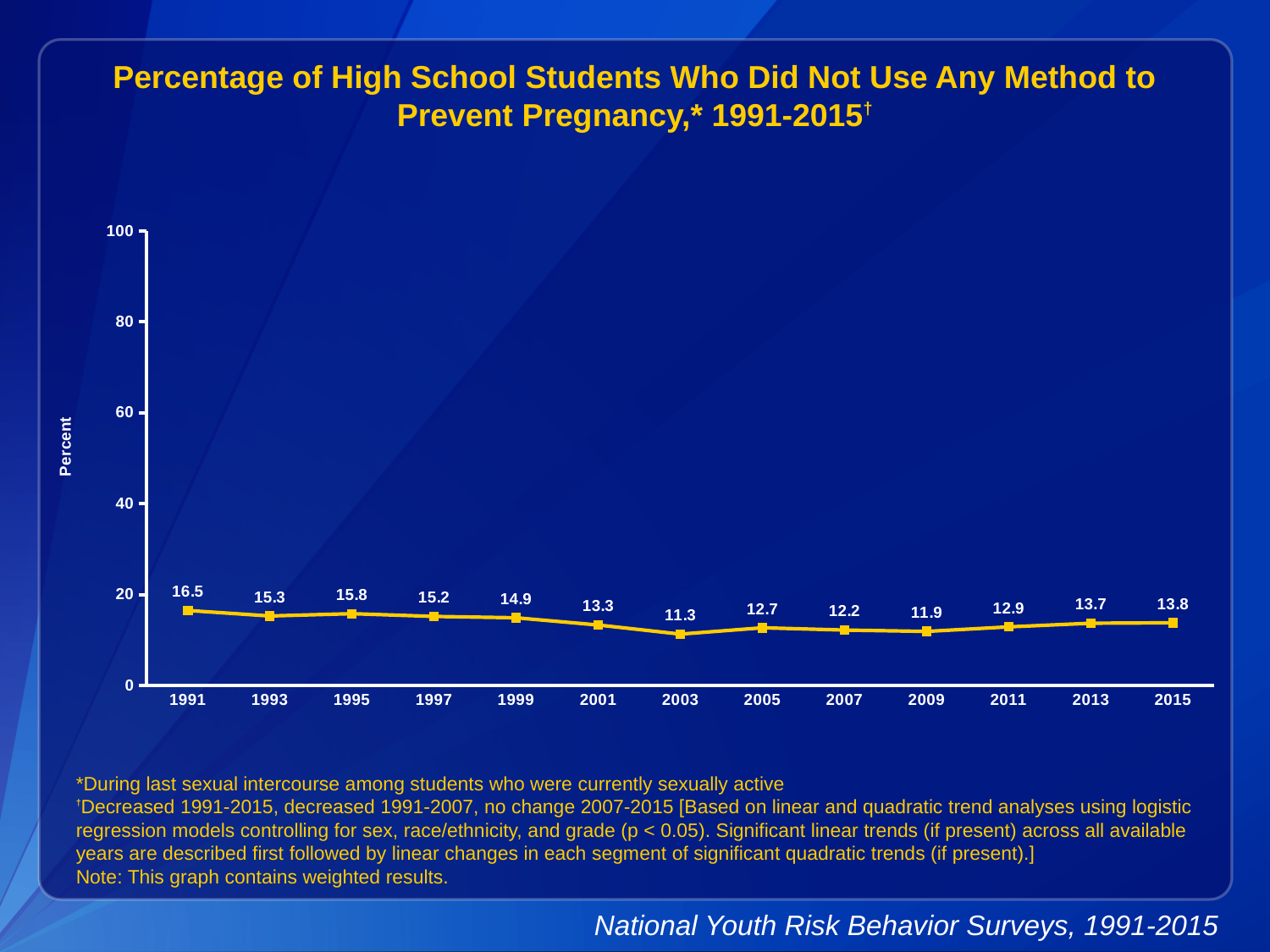
Do the values generally rise or fall from 1991 to 2003? fall What is the label on the y axis? Percent Which year has the highest value on the chart? 1991 Which year has the lowest value on the chart? 2003 How many years are plotted on the x axis? 13 Which year has a larger value, 1995 or 2011? 1995 What value is shown for 2015? 13.8 What kind of chart is shown on the slide? line chart What value is shown for 2003? 11.3 Is the value for 1999 greater or less than 20? less What is the difference between the 1991 value and the 2015 value? 2.7 What was the percentage of high school students who did not use any method to prevent pregnancy in 1991? 16.5